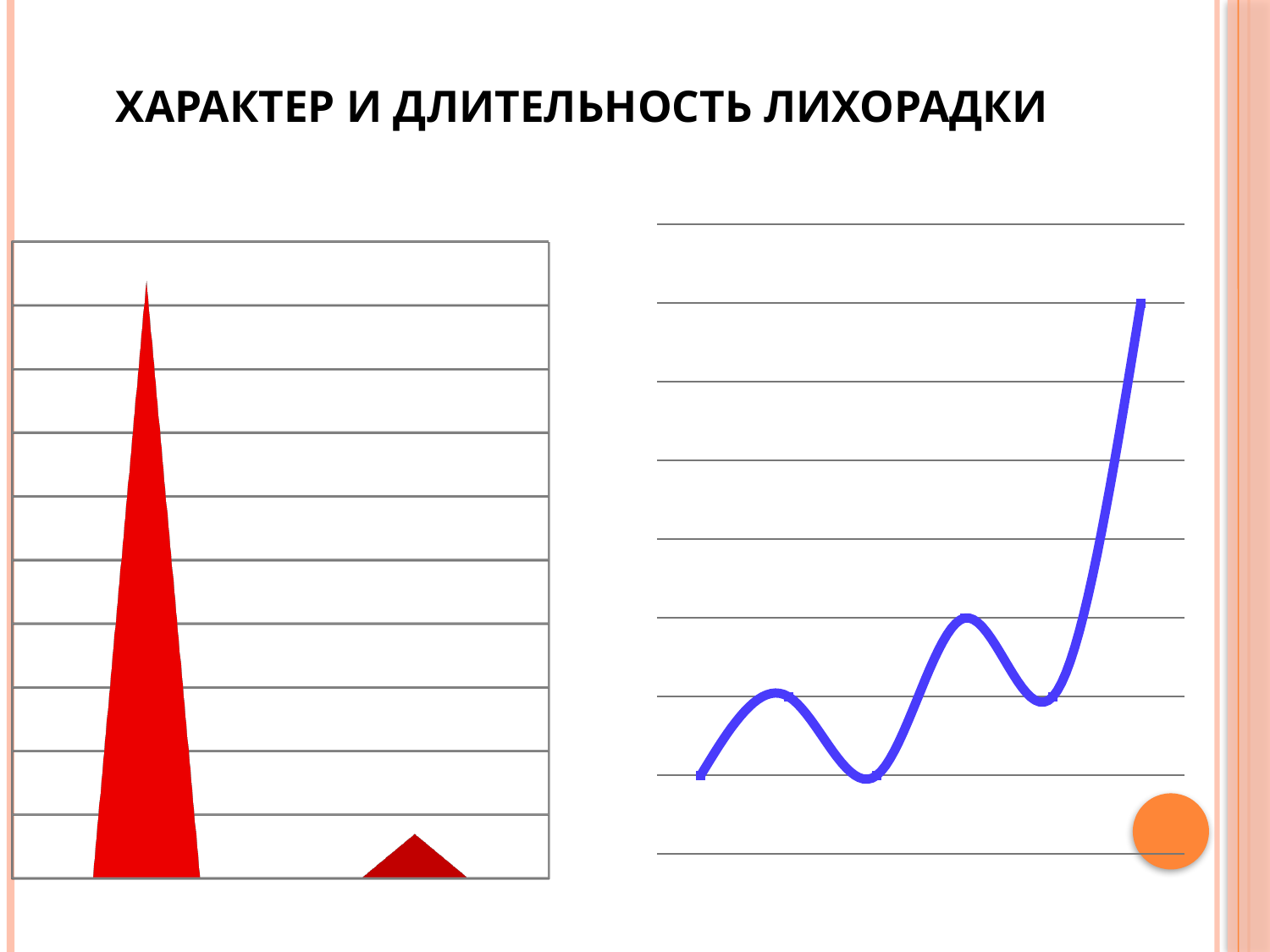
In the chart on the right side of the slide, do the values overall rise or fall from left to right? rise What colour is the line in the chart on the right side of the slide? blue What kind of chart is the chart on the right side of the slide? line chart How many data points are marked on the line in the chart on the right side of the slide? 6 In the chart on the left side of the slide, which of the two red shapes is taller, the left one or the right one? the left one In the chart on the right side of the slide, is the last point higher or lower than the first point? higher What is the title of the slide containing the two charts? ХАРАКТЕР И ДЛИТЕЛЬНОСТЬ ЛИХОРАДКИ How many shapes are plotted in the chart on the left side of the slide? 2